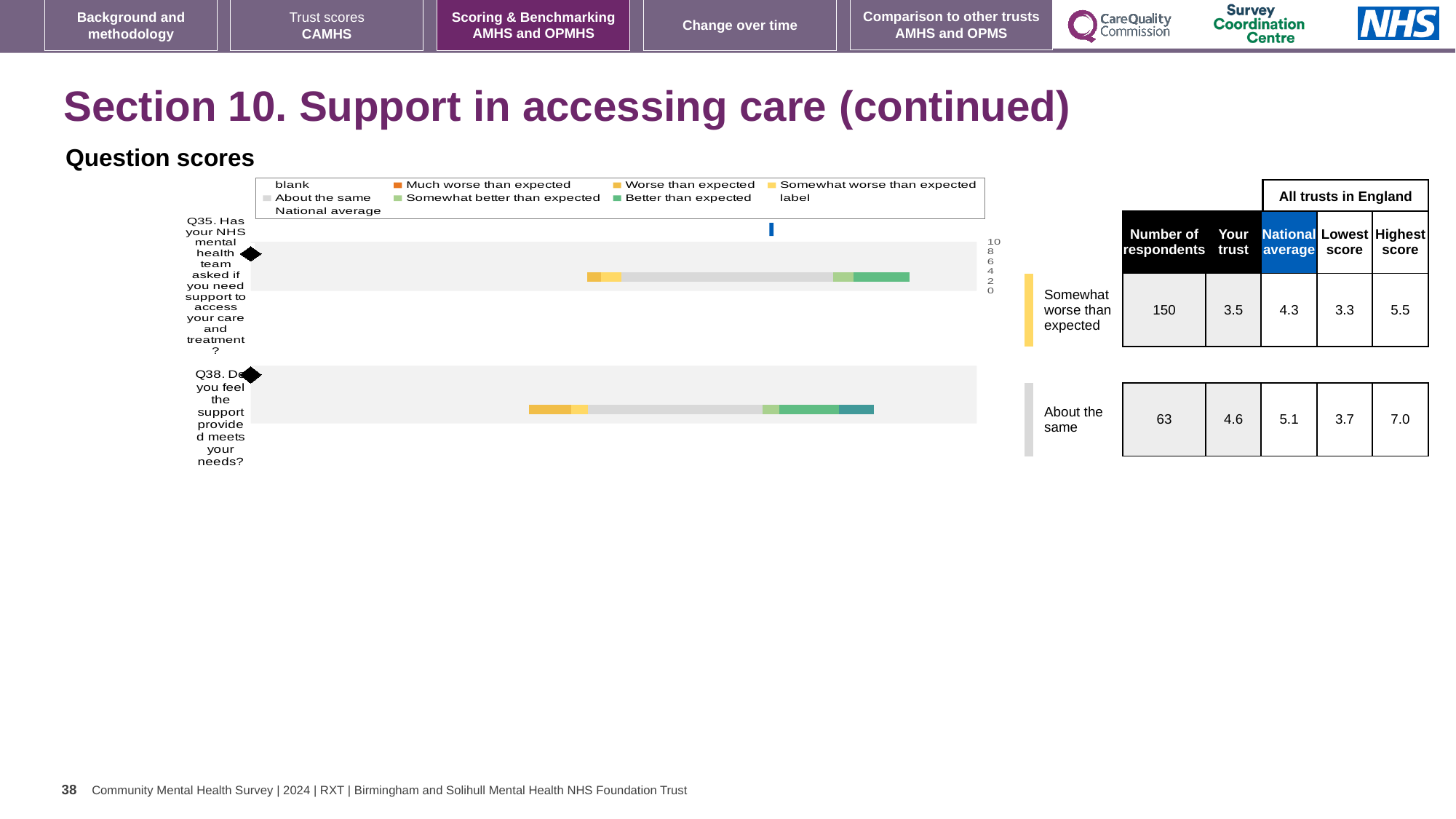
What colour does the legend use for 'About the same'? grey According to the table beside the chart, what is the 'Your trust' score for Q38? 4.6 How many questions (categories) are plotted in the chart? 2 What is the difference between the highest scores for Q38 and Q35? 1.5 What kind of chart is shown under 'Question scores'? bar chart How many entries does the chart legend list? 9 According to the table beside the chart, how many respondents answered Q35? 150 According to the table beside the chart, what is the 'Your trust' score for Q35? 3.5 What is the difference between the 'Your trust' scores for Q38 and Q35? 1.1 Which question has the higher 'Your trust' score, Q35 or Q38? Q38 According to the table beside the chart, what is the national average for Q38? 5.1 What is the highest tick value shown on the chart's axis? 10